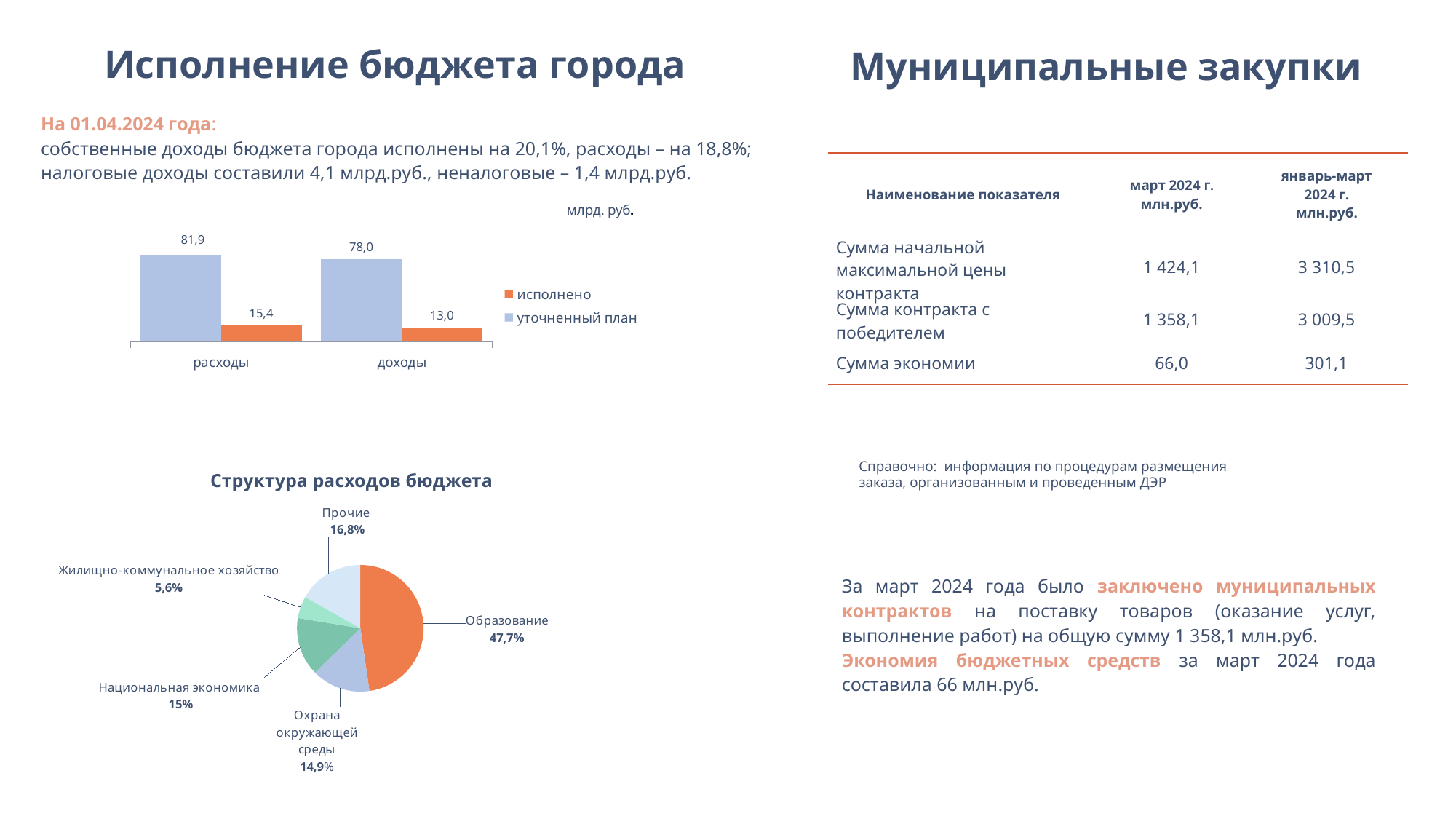
In the pie chart 'Структура расходов бюджета', which category has the largest share? Образование In the bar chart at the top left of the slide, what is the value of 'уточненный план' for 'расходы'? 81,9 In the pie chart 'Структура расходов бюджета', which category has the smallest share? Жилищно-коммунальное хозяйство In the bar chart at the top left of the slide, which category has the higher 'исполнено' value, 'расходы' or 'доходы'? расходы In the bar chart at the top left of the slide, which colour represents 'исполнено'? orange How many categories are shown in the pie chart 'Структура расходов бюджета'? 5 In the pie chart 'Структура расходов бюджета', what share does 'Образование' have? 47,7% In the pie chart 'Структура расходов бюджета', what is the difference between the shares of 'Прочие' and 'Охрана окружающей среды'? 1,9% In the bar chart at the top left of the slide, what is the value of 'исполнено' for 'доходы'? 13,0 What type of chart is the chart at the top left of the slide? bar chart How many series does the legend of the bar chart at the top left of the slide list? 2 In the bar chart at the top left of the slide, what is the difference between 'уточненный план' and 'исполнено' for 'расходы'? 66,5